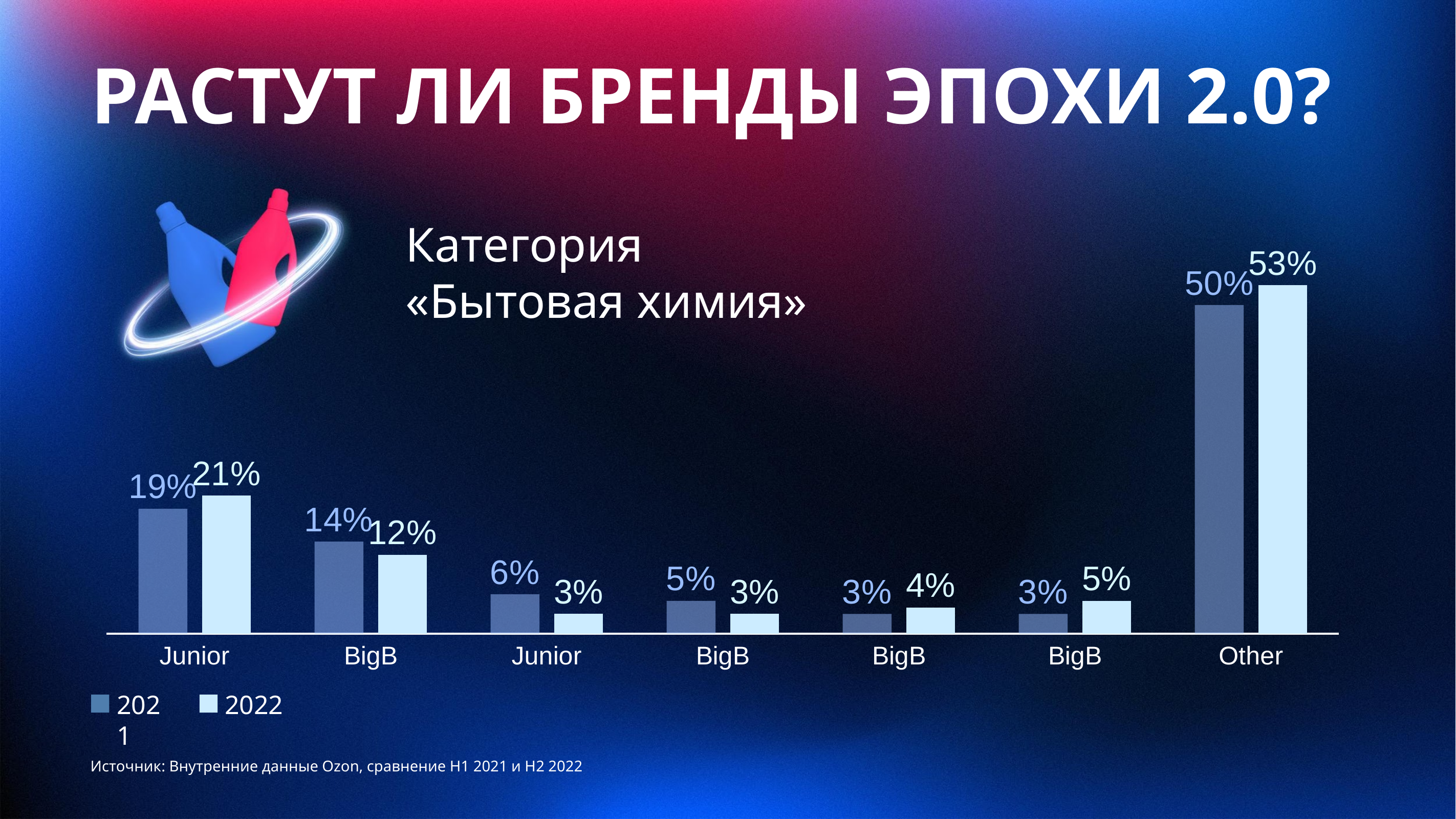
Which category has the highest value in 2022? Other For the Other category, which is larger: the 2021 value or the 2022 value? 2022 How many category groups are shown on the x axis? 7 What is the 2022 value for the Other category? 53% What is the difference between the 2022 and 2021 values for the Other category? 3 percentage points What are the two series named in the legend? 2021 and 2022 What is the 2021 value for the first Junior category (leftmost group)? 19% What is the 2021 value for the Other category? 50% What is the 2022 value for the first Junior category (leftmost group)? 21% What kind of chart is shown on the slide? Bar chart How many series does the legend list? 2 What is the lowest 2022 value shown on the chart? 3%